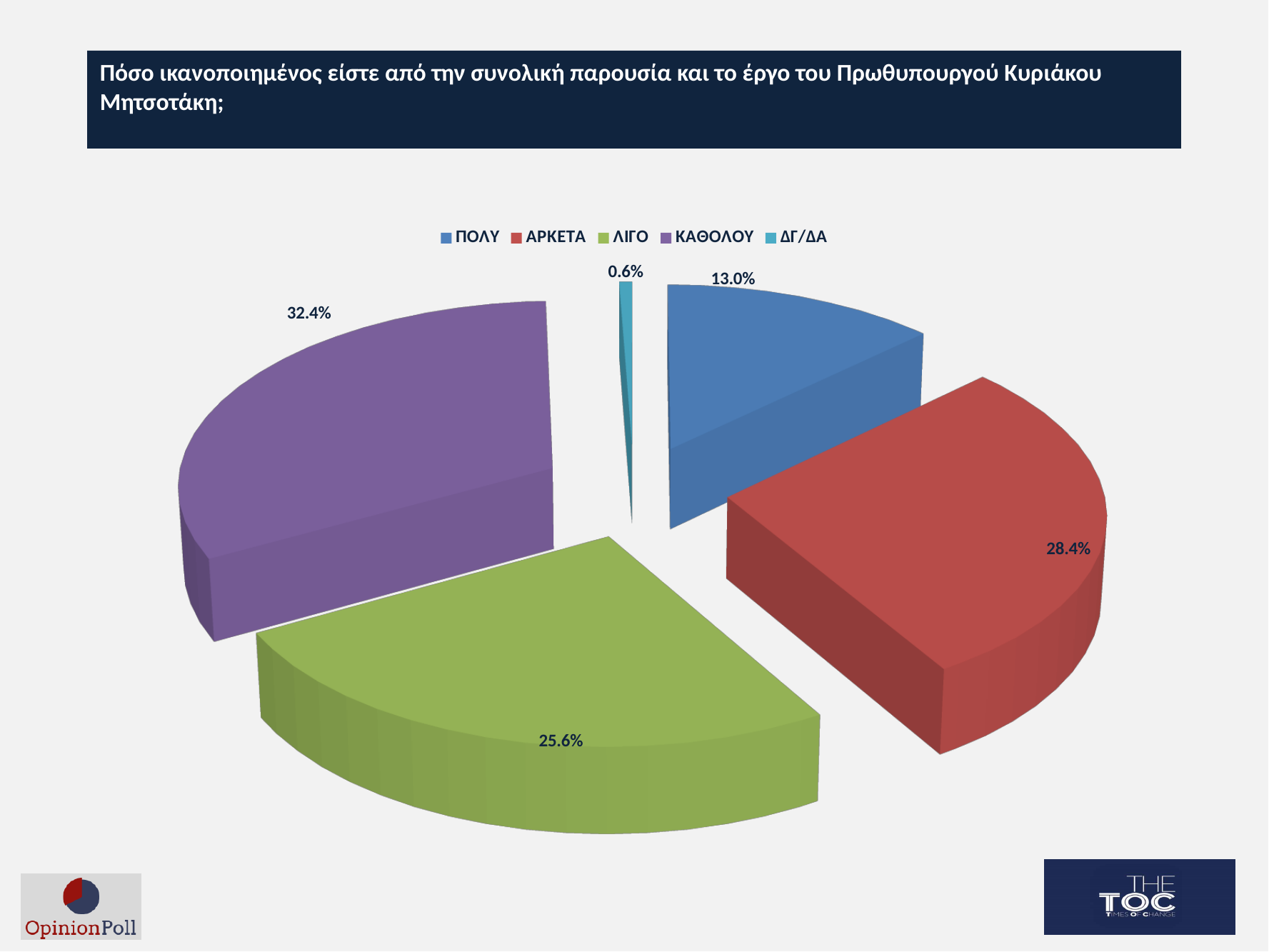
What kind of chart is shown on the slide? Pie chart What percentage of respondents answered ΚΑΘΟΛΟΥ? 32.4% Which response category has the largest share of the pie? ΚΑΘΟΛΟΥ What percentage of respondents answered ΛΙΓΟ? 25.6% How many categories does the legend list? 5 Which response category has the smallest share of the pie? ΔΓ/ΔΑ What percentage of respondents answered ΔΓ/ΔΑ? 0.6% What is the difference in percentage points between ΚΑΘΟΛΟΥ and ΠΟΛΥ? 19.4 What colour is the slice for ΚΑΘΟΛΟΥ? Purple What percentage of respondents answered ΠΟΛΥ? 13.0% What percentage of respondents answered ΑΡΚΕΤΑ? 28.4% Which is larger, the share for ΑΡΚΕΤΑ or the share for ΛΙΓΟ? ΑΡΚΕΤΑ